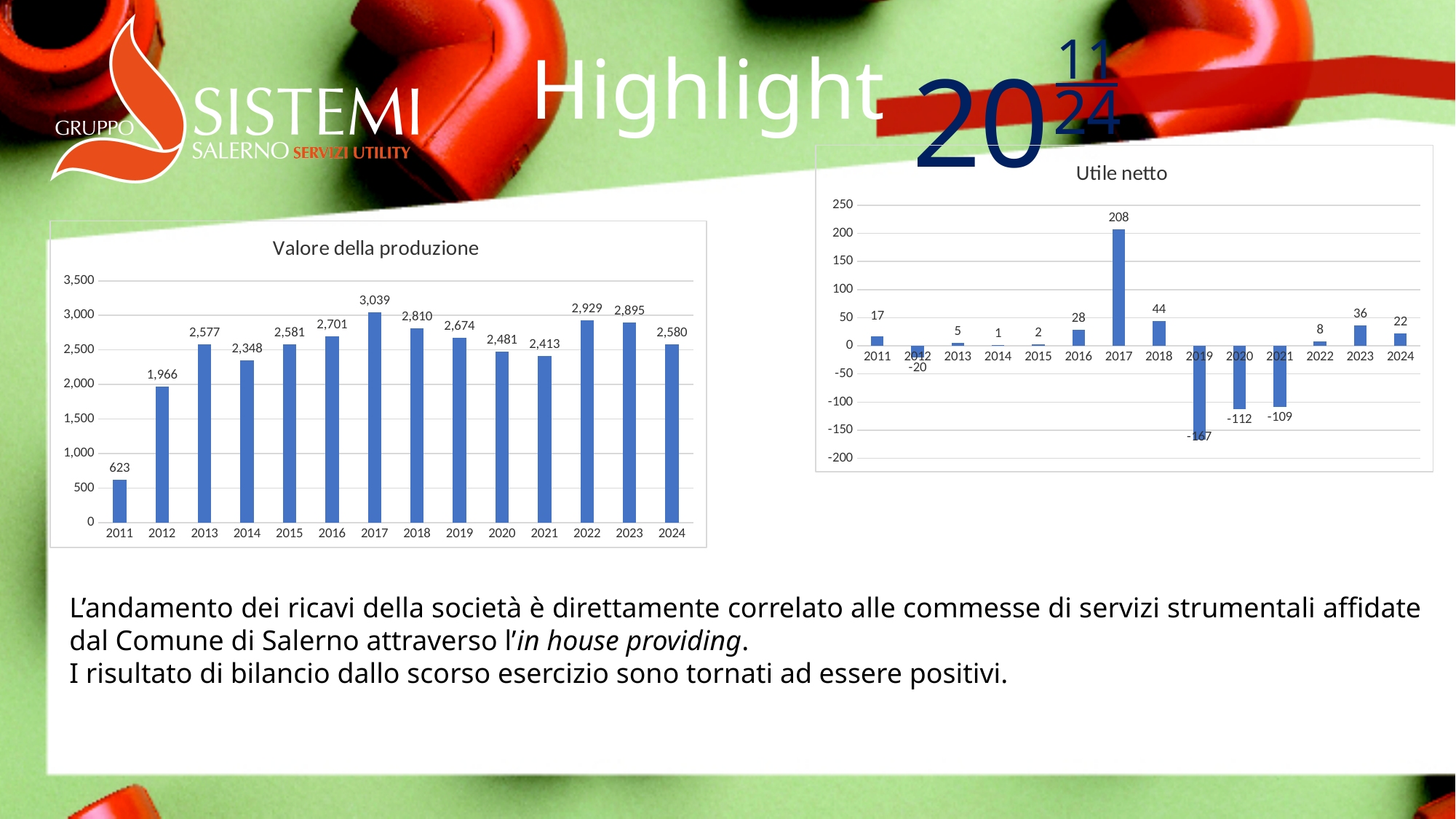
In the 'Utile netto' chart, which year has the lowest value? 2019 What kind of chart is 'Valore della produzione'? bar chart In the 'Valore della produzione' chart, what is the value for 2017? 3,039 In the 'Valore della produzione' chart, what is the difference between the values for 2022 and 2021? 516 In the 'Utile netto' chart, which year has the highest value? 2017 In the 'Valore della produzione' chart, which is larger, the value for 2013 or the value for 2014? 2013 In the 'Utile netto' chart, what is the difference between the values for 2023 and 2024? 14 In the 'Valore della produzione' chart, how many years are shown on the x axis? 14 In the 'Utile netto' chart, what is the value for 2019? -167 In the 'Valore della produzione' chart, which year has the lowest value? 2011 In the 'Utile netto' chart, is the value for 2017 greater or less than 200? greater In the 'Utile netto' chart, what is the value for 2012? -20